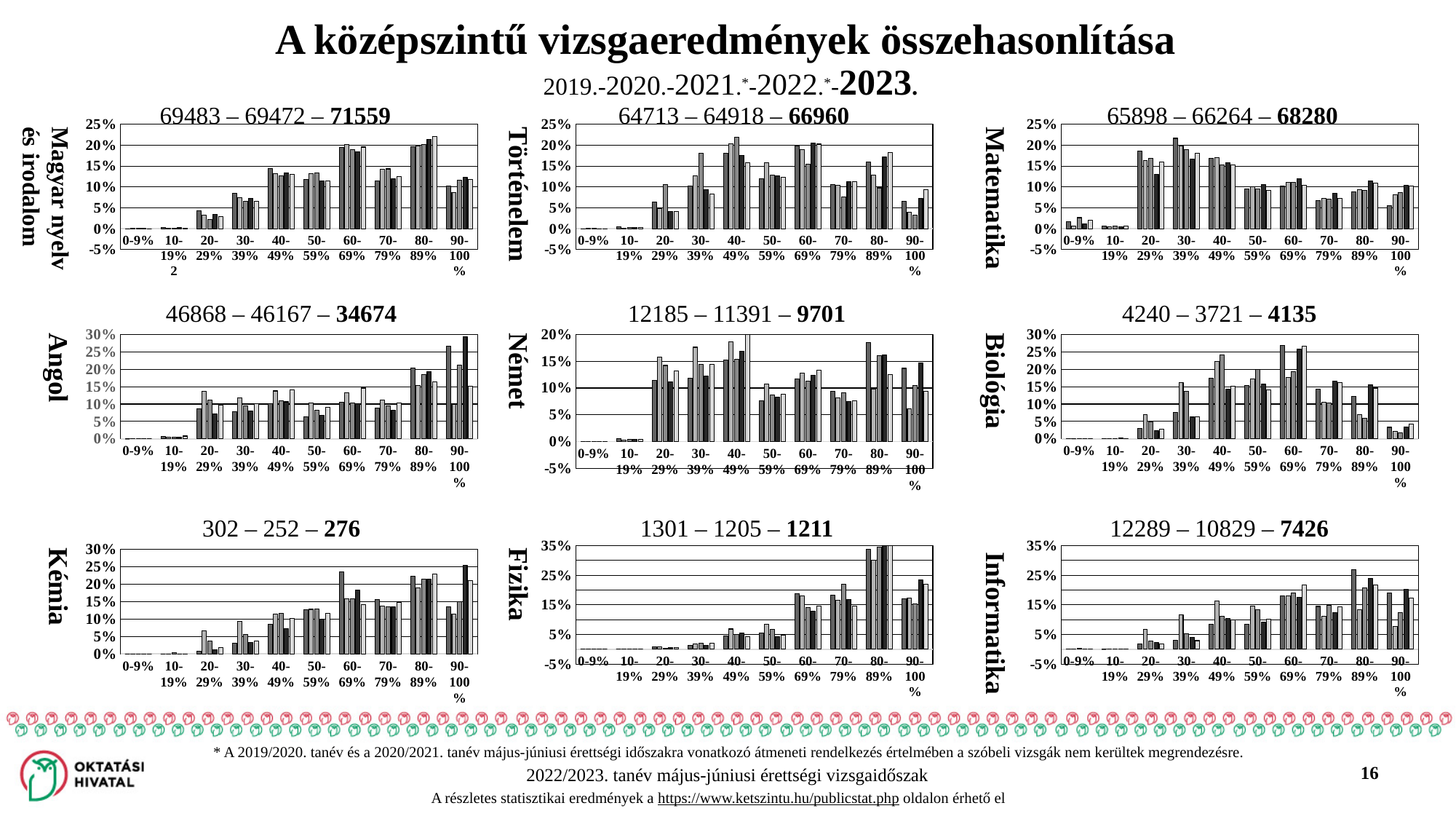
In the Biológia chart, are the values for the 90-100% band greater or less than 5%? less In the Angol chart, which score band contains the tallest bar? 90-100% What is the title printed above the Angol chart? 46868 – 46167 – 34674 What is the title printed above the Matematika chart? 65898 – 66264 – 68280 How many charts are shown on the slide? 9 In the Fizika chart, are the values for the 80-89% band greater or less than 25%? greater What kind of chart is the Magyar nyelv és irodalom chart? bar chart In the Fizika chart, which score band has the highest values? 80-89% In the Magyar nyelv és irodalom chart, are the values for the 60-69% band greater or less than 15%? greater How many score-band categories does the Kémia chart show on its x axis? 10